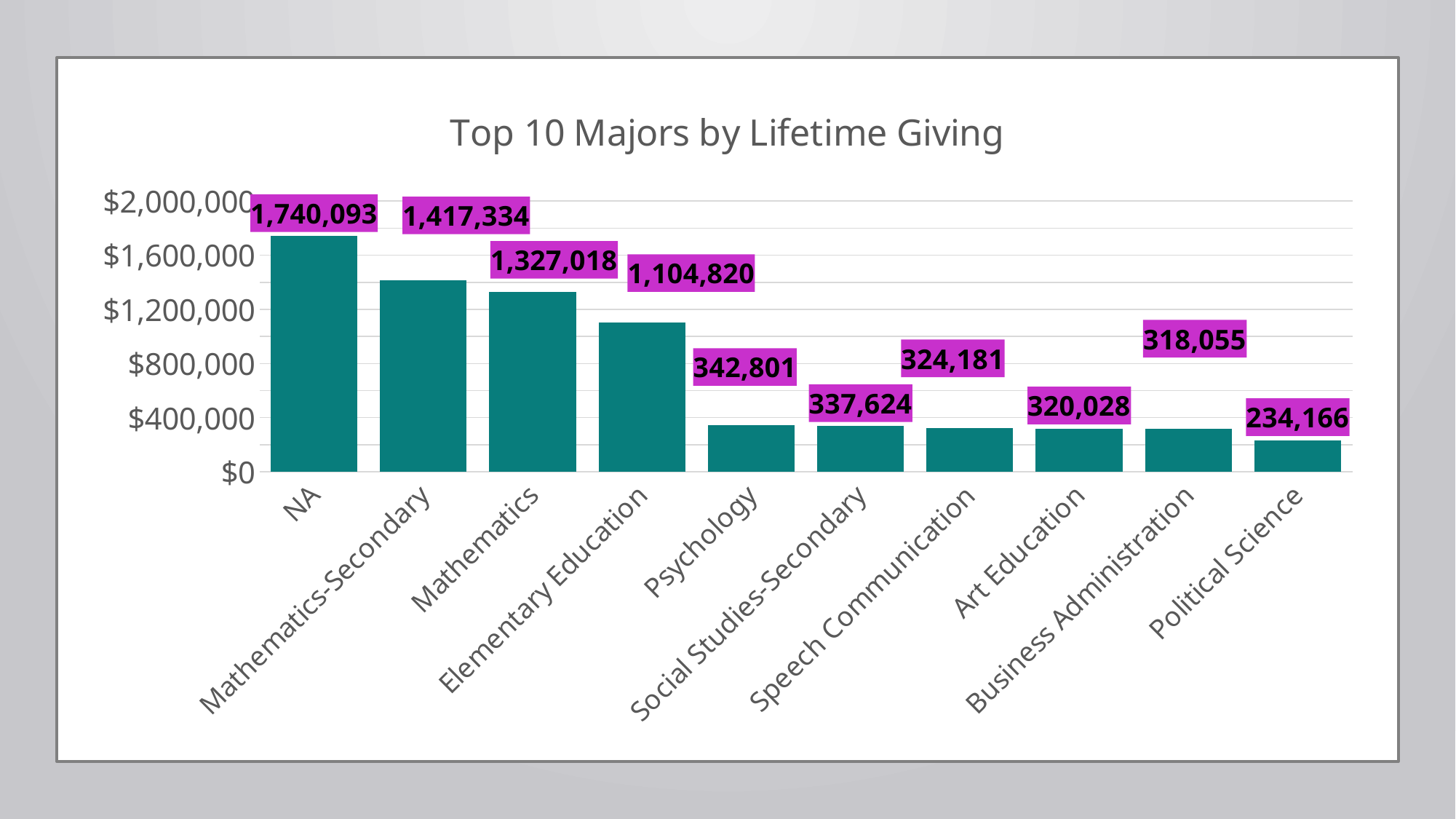
What is the difference between the values for NA and Mathematics-Secondary? 322,759 Which is larger, the value for Social Studies-Secondary or the value for Art Education? Social Studies-Secondary What is the lifetime giving value for Psychology? 342,801 What kind of chart is shown on the slide? bar chart Is the value for Elementary Education greater or less than $800,000? greater What is the lifetime giving value for Business Administration? 318,055 How many majors are shown in the chart? 10 Which major has the highest lifetime giving? NA Which major has the lowest lifetime giving? Political Science What is the difference between the values for Elementary Education and Psychology? 762,019 What is the title of the chart? Top 10 Majors by Lifetime Giving What is the lifetime giving value for Mathematics? 1,327,018